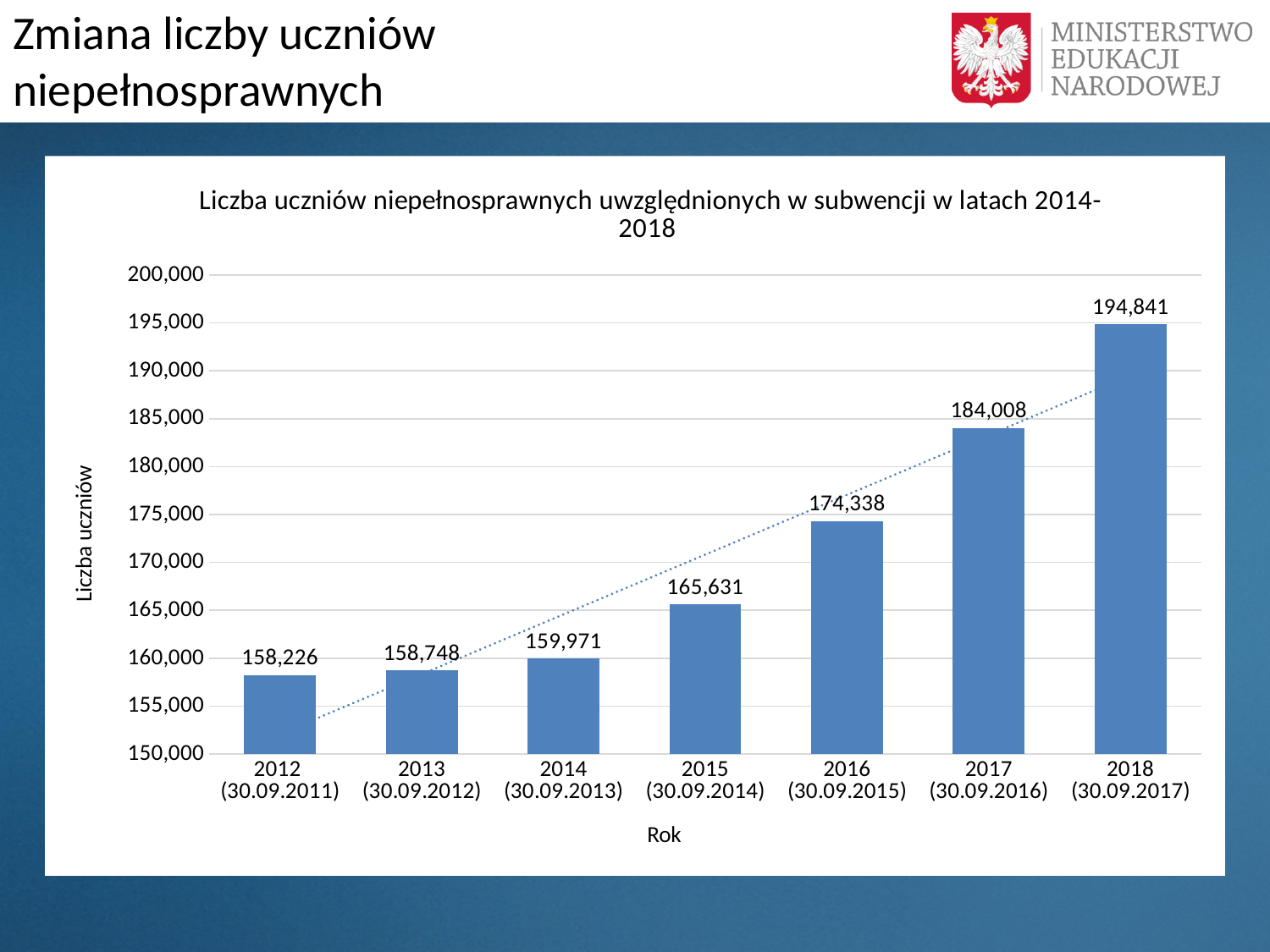
What is the number of students for 2015 (30.09.2014)? 165,631 What kind of chart is this? bar chart What is the difference between the values for 2018 and 2017? 10,833 What is the number of students for 2018 (30.09.2017)? 194,841 Which year has the lowest number of students? 2012 (30.09.2011) How many years are shown on the x axis? 7 Do the values rise or fall from 2012 to 2018? rise What is the number of students for 2012 (30.09.2011)? 158,226 What is the difference between the values for 2016 and 2015? 8,707 Which year has the highest number of students? 2018 (30.09.2017) Which is larger, the value for 2014 or the value for 2016? 2016 What is the number of students for 2017 (30.09.2016)? 184,008